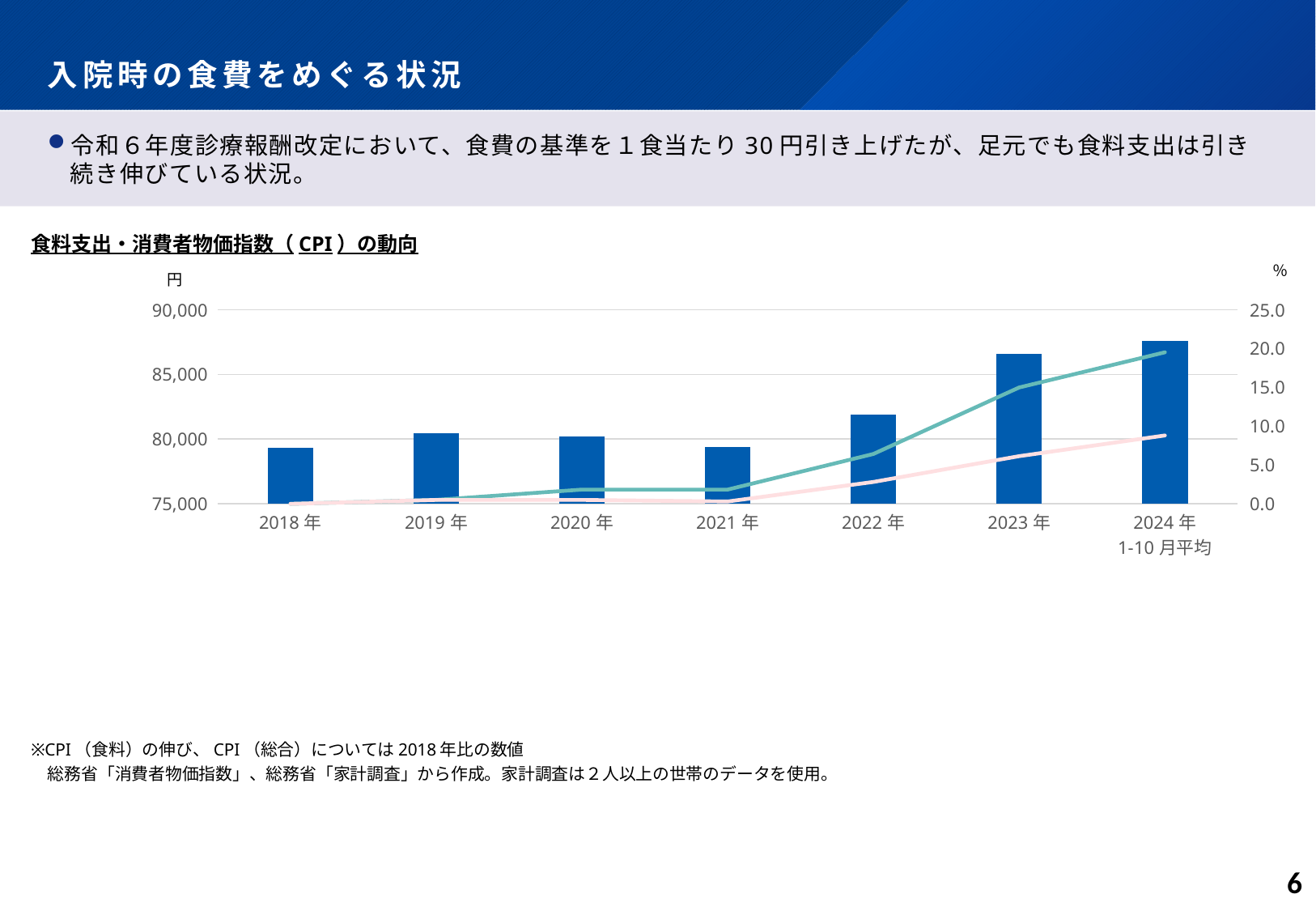
Is the bar value for 2023年 greater or less than 85,000? greater What is the title of the chart? 食料支出・消費者物価指数（CPI）の動向 Which year has the tallest bar in the chart? 2024年1-10月平均 Is the green line's value at 2024年1-10月平均 greater or less than 15.0 on the right axis? greater What kind of chart is shown on the slide? A combined bar and line chart How many year categories are shown on the x axis of the chart? 7 Which bar is taller, 2022年 or 2019年? 2022年 What unit is shown on the left vertical axis of the chart? 円 Which bar is taller, 2023年 or 2022年? 2023年 Is the bar value for 2018年 greater or less than 80,000? less Does the green line rise or fall from 2018年 to 2024年1-10月平均? rise